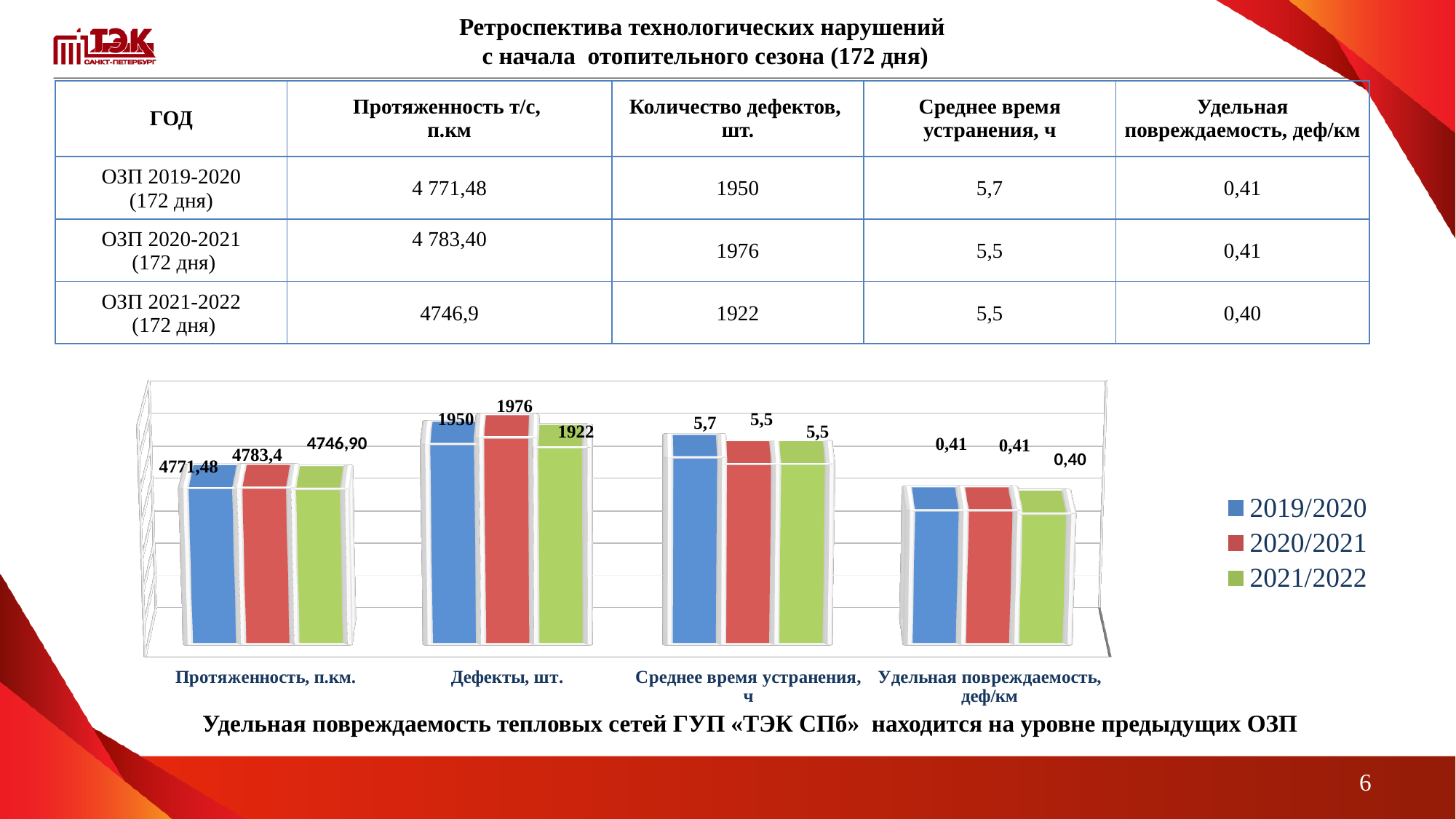
What is the value for 2019/2020 in the category "Среднее время устранения, ч"? 5,7 What is the value for 2021/2022 in the category "Протяженность, п.км."? 4746,90 How many categories are shown on the x axis of the chart? 4 In the category "Среднее время устранения, ч", which is larger: the value for 2019/2020 or for 2021/2022? 2019/2020 What kind of chart is shown on the slide? bar chart What is the value for 2020/2021 in the category "Дефекты, шт."? 1976 What is the difference between the 2020/2021 and 2021/2022 values in the category "Дефекты, шт."? 54 Which series has the highest value in the category "Дефекты, шт."? 2020/2021 How many series does the chart legend list? 3 Which series has the lowest value in the category "Дефекты, шт."? 2021/2022 What is the value for 2021/2022 in the category "Удельная повреждаемость, деф/км"? 0,40 Which legend entry is shown in green? 2021/2022